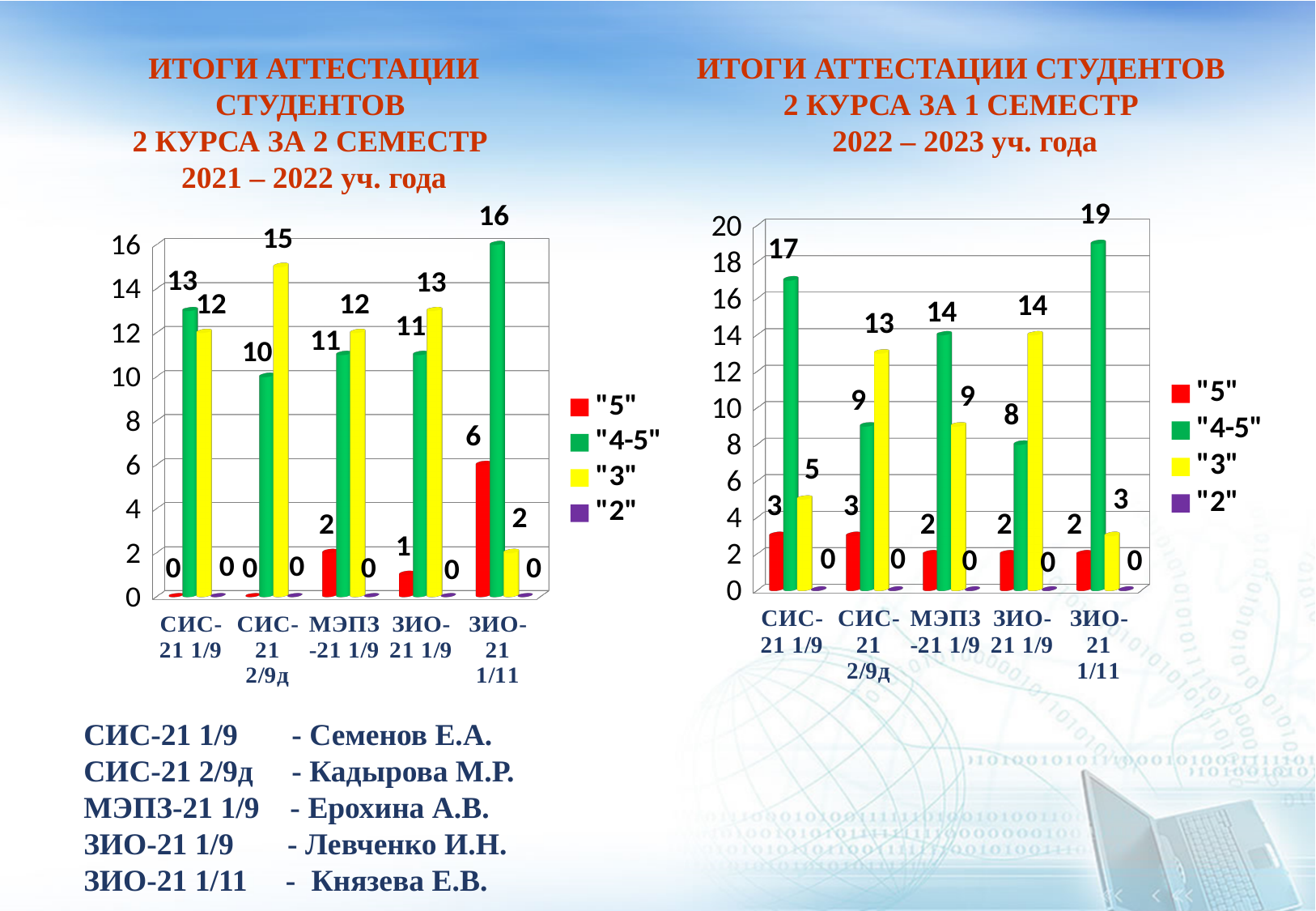
In the right chart (1 семестр 2022–2023), is the "3" value for СИС-21 2/9д larger or the "3" value for МЭПЗ-21 1/9? СИС-21 2/9д In the right chart (1 семестр 2022–2023), which group has the highest value for the "4-5" series? ЗИО-21 1/11 In the left chart (2 семестр 2021–2022), how many groups are shown on the x axis? 5 What type of chart is the left chart (2 семестр 2021–2022)? Bar chart In the left chart (2 семестр 2021–2022), what is the difference between the "4-5" and "3" values for ЗИО-21 1/11? 14 In the left chart (2 семестр 2021–2022), which group has the highest value for the "5" series? ЗИО-21 1/11 In the right chart (1 семестр 2022–2023), which group has the lowest value for the "4-5" series? ЗИО-21 1/9 How many series does the legend of the right chart (1 семестр 2022–2023) list? 4 In the left chart (2 семестр 2021–2022), what is the value of the "4-5" series for ЗИО-21 1/11? 16 In the left chart (2 семестр 2021–2022), what is the value of the "3" series for СИС-21 2/9д? 15 In the right chart (1 семестр 2022–2023), what is the value of the "4-5" series for СИС-21 1/9? 17 In the right chart (1 семестр 2022–2023), what is the difference between the "4-5" value for ЗИО-21 1/11 and the "4-5" value for ЗИО-21 1/9? 11